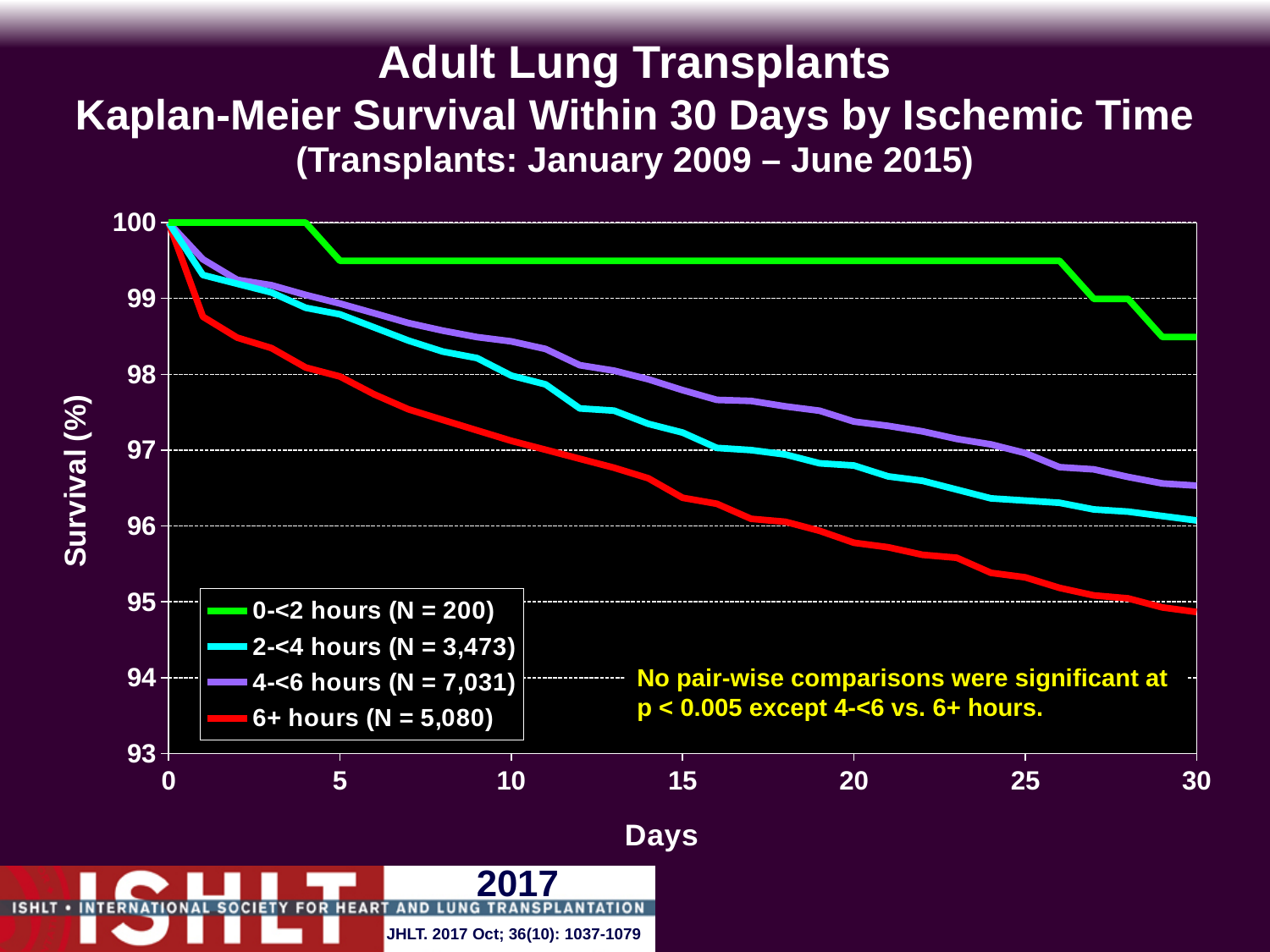
How many series does the legend list? 4 Does survival rise or fall as days increase for the 6+ hours group? fall At day 20, which group has higher survival: 4-<6 hours or 2-<4 hours? 4-<6 hours Which ischemic time group has the highest survival at day 30? 0-<2 hours What type of chart is shown on the slide? Line chart According to the legend, what is N for the 2-<4 hours group? 3,473 Is the survival for the 0-<2 hours group at day 15 greater or less than 99? greater Is the survival for the 6+ hours group at day 15 greater or less than 97? less Which ischemic time group has the lowest survival at day 30? 6+ hours Is the survival for the 4-<6 hours group at day 10 greater or less than 98? greater What is the survival (%) for the 0-<2 hours group at day 2? 100 What is the survival (%) for all groups at day 0? 100